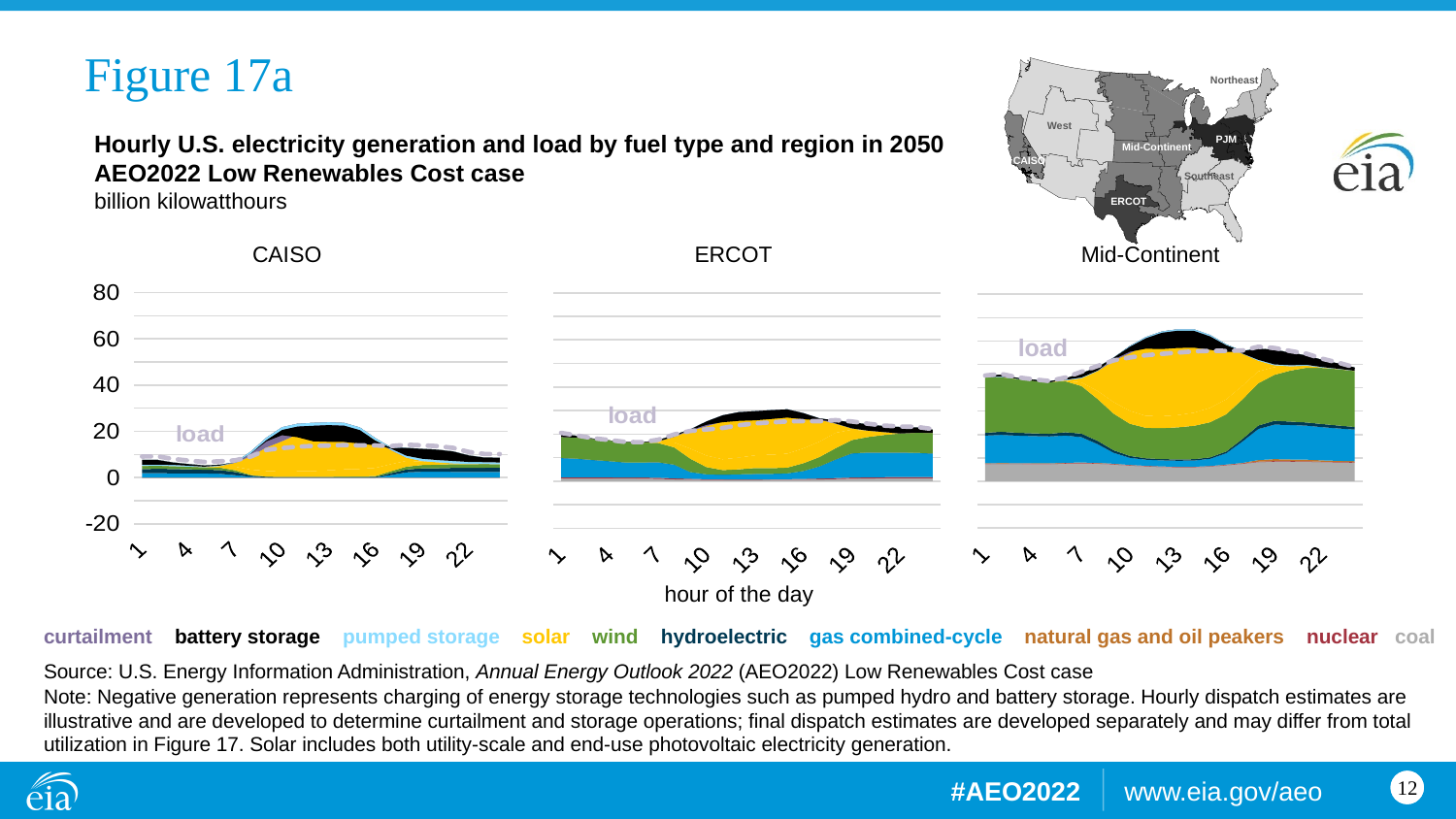
Which of the three regions has the highest peak total generation? Mid-Continent In the ERCOT chart, is the peak total generation greater or less than 40? less In the Mid-Continent chart, is the peak value of the load line greater or less than 40? greater What unit are the charts measured in? billion kilowatthours In the CAISO chart, is the peak total generation greater or less than 40? less Which of the three regions has the lowest peak total generation? CAISO What is the label on the x axis of the charts? hour of the day How many fuel-type series does the legend list? 10 How many regional charts are shown on the slide? 3 In the Mid-Continent chart, does the load line rise or fall between hour 1 and hour 13? rise What kind of chart is used for the CAISO panel? stacked area chart